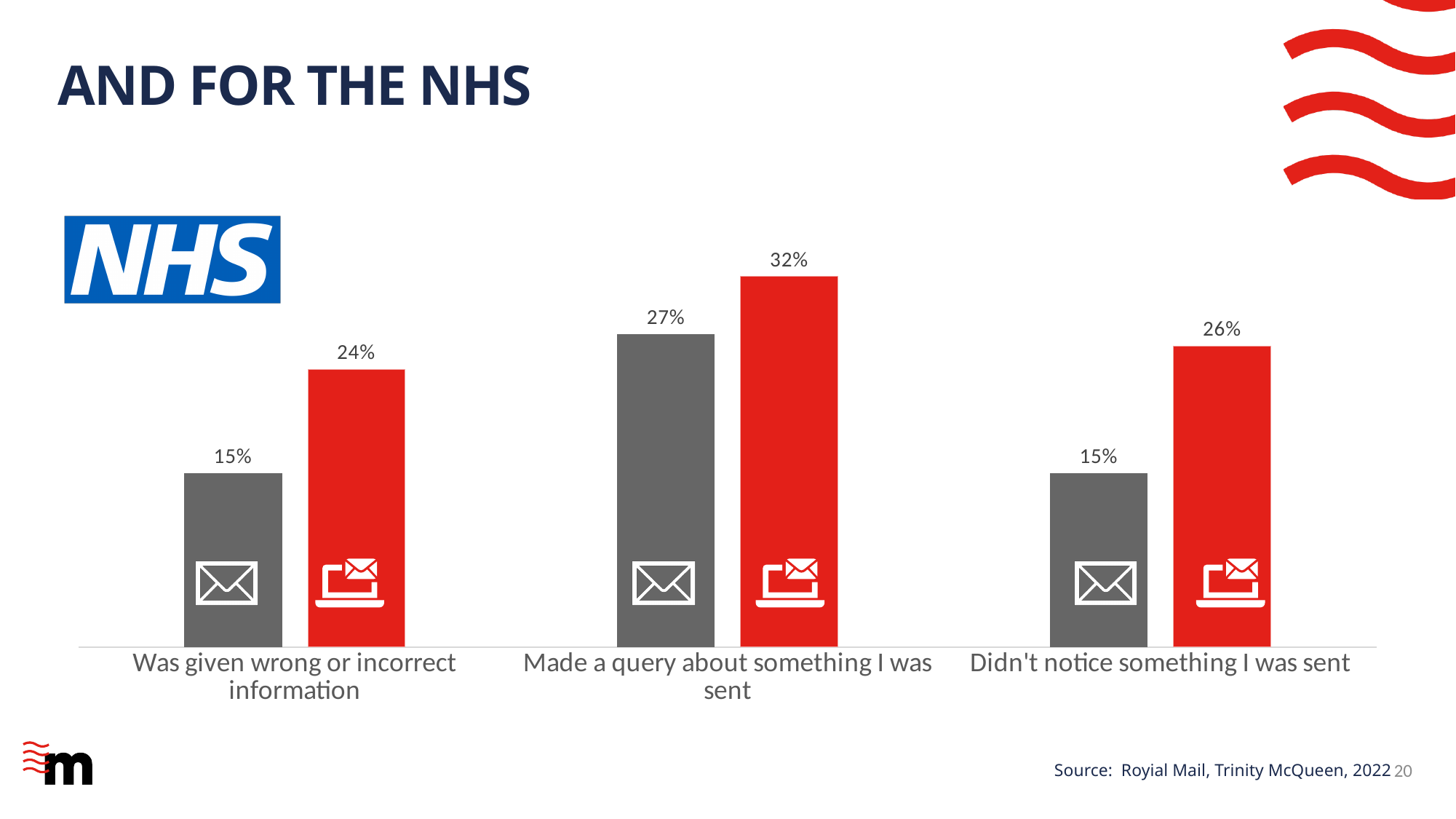
What is the value of the grey bar (envelope icon) for "Was given wrong or incorrect information"? 15% What is the difference between the red bar and the grey bar for "Was given wrong or incorrect information"? 9% Which category has the highest red bar (laptop icon) value? Made a query about something I was sent Which is larger for "Made a query about something I was sent": the grey bar or the red bar? the red bar What is the title of the slide containing the chart? AND FOR THE NHS What is the difference between the red bar and the grey bar for "Didn't notice something I was sent"? 11% How many categories are shown on the x axis of the chart? 3 What is the value of the grey bar (envelope icon) for "Made a query about something I was sent"? 27% What is the value of the red bar (laptop icon) for "Didn't notice something I was sent"? 26% Which category has the highest grey bar (envelope icon) value? Made a query about something I was sent What is the value of the red bar (laptop icon) for "Made a query about something I was sent"? 32% What kind of chart is shown on the slide? bar chart